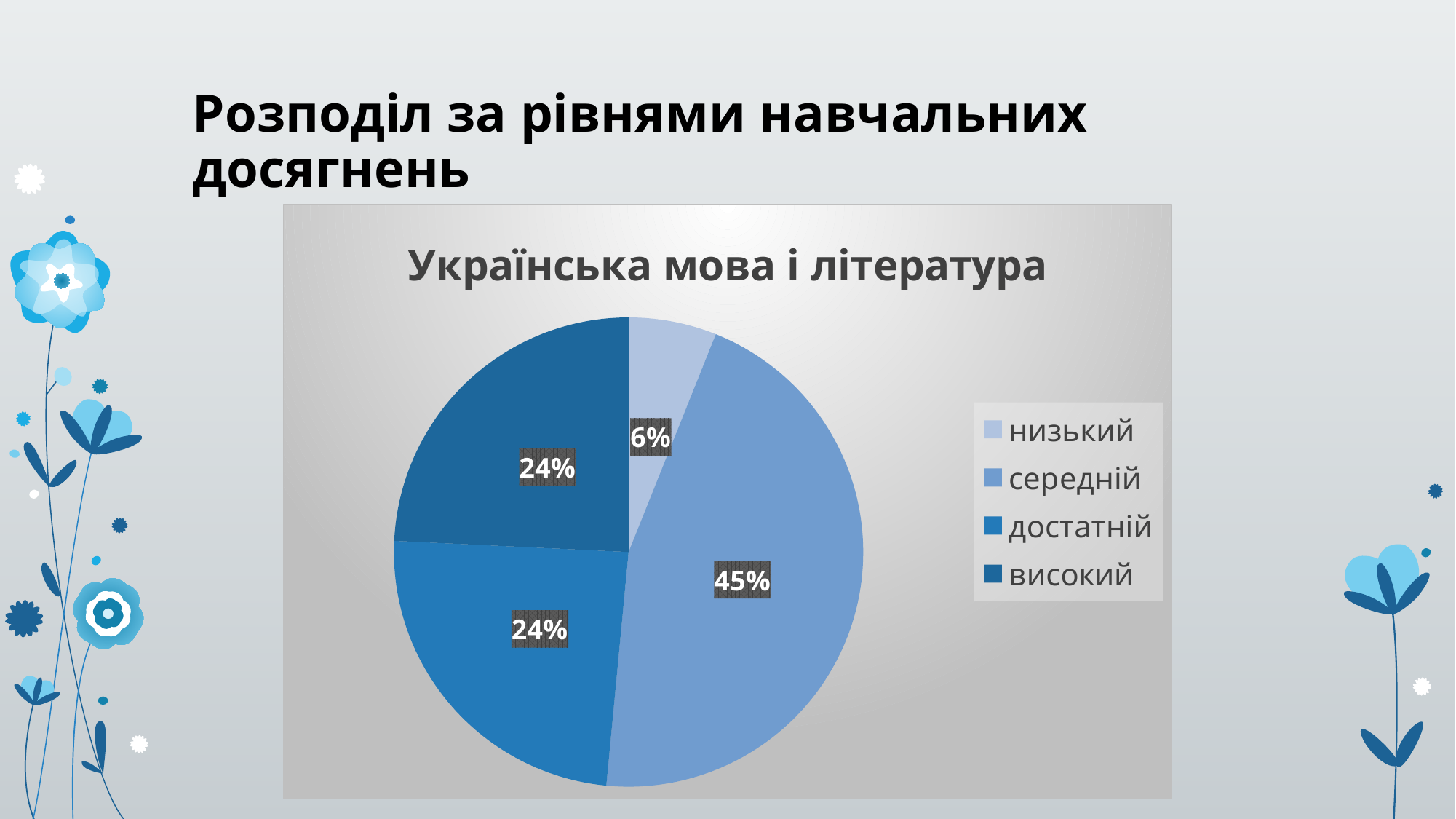
Which level has the largest slice of the pie? середній How many entries does the legend list? 4 Which level has the smallest slice of the pie? низький What type of chart is shown on the slide? pie chart Which is larger, the "середній" slice or the "високий" slice? середній What share of the pie does the "середній" level have? 45% What share of the pie does the "достатній" level have? 24% What is the chart's title? Українська мова і література What share of the pie does the "високий" level have? 24% How many categories does the pie chart show? 4 What share of the pie does the "низький" level have? 6% What is the difference in percentage points between the "середній" and "низький" slices? 39